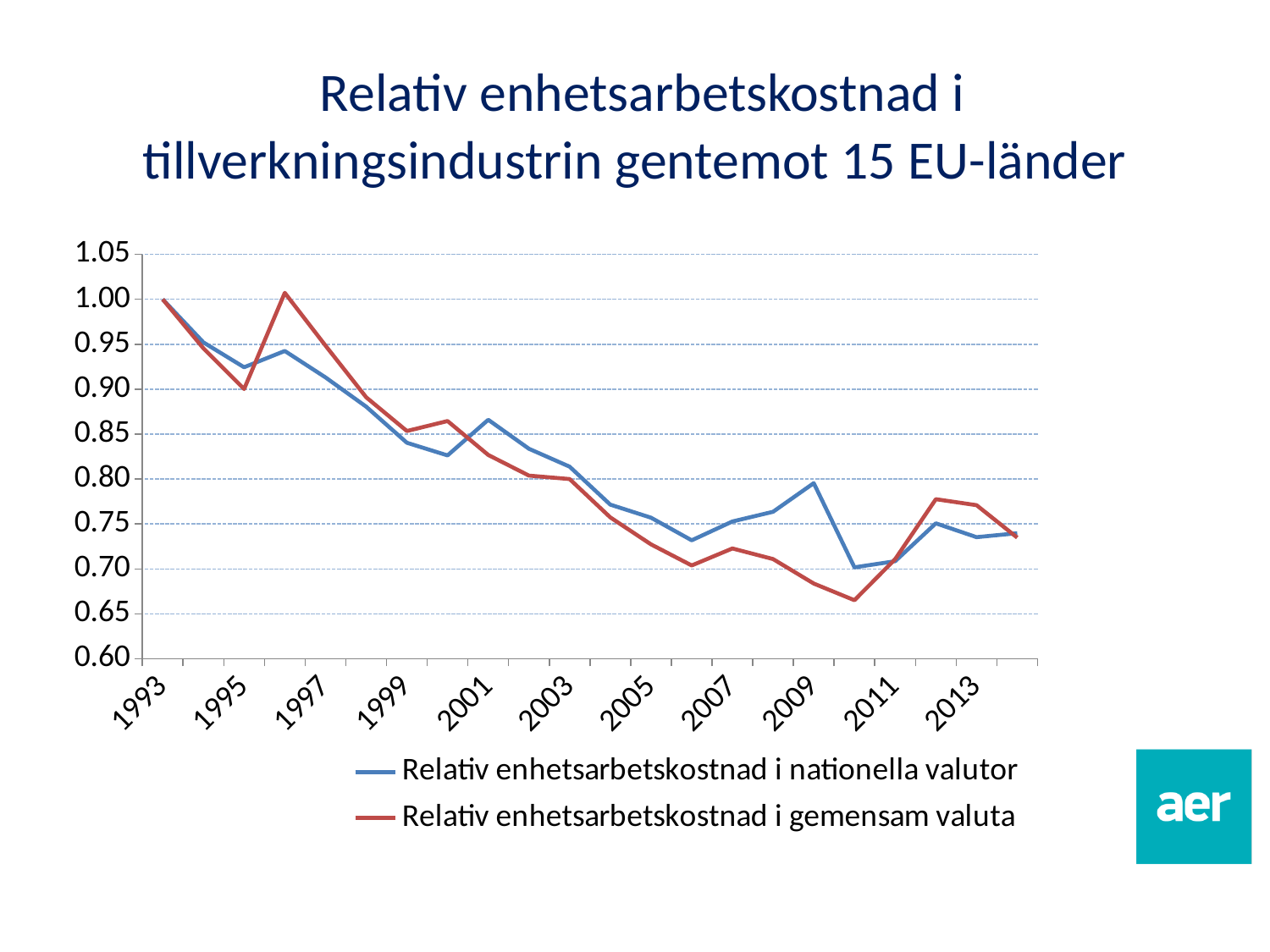
What kind of chart is shown on the slide? line chart Is the value for 'Relativ enhetsarbetskostnad i nationella valutor' in 2009 greater or less than 0.75? greater In 2009, which series has the higher value? Relativ enhetsarbetskostnad i nationella valutor What is the title of the chart? Relativ enhetsarbetskostnad i tillverkningsindustrin gentemot 15 EU-länder What is the value of 'Relativ enhetsarbetskostnad i nationella valutor' in 1993? 1.00 In 1997, which series has the higher value? Relativ enhetsarbetskostnad i gemensam valuta What is the value of 'Relativ enhetsarbetskostnad i gemensam valuta' in 1993? 1.00 Is the value for 'Relativ enhetsarbetskostnad i gemensam valuta' in 2009 greater or less than 0.70? less Do the values of 'Relativ enhetsarbetskostnad i nationella valutor' generally rise or fall from 1993 to the end of the series? fall How many series does the legend list? 2 Which series is drawn in red according to the legend? Relativ enhetsarbetskostnad i gemensam valuta